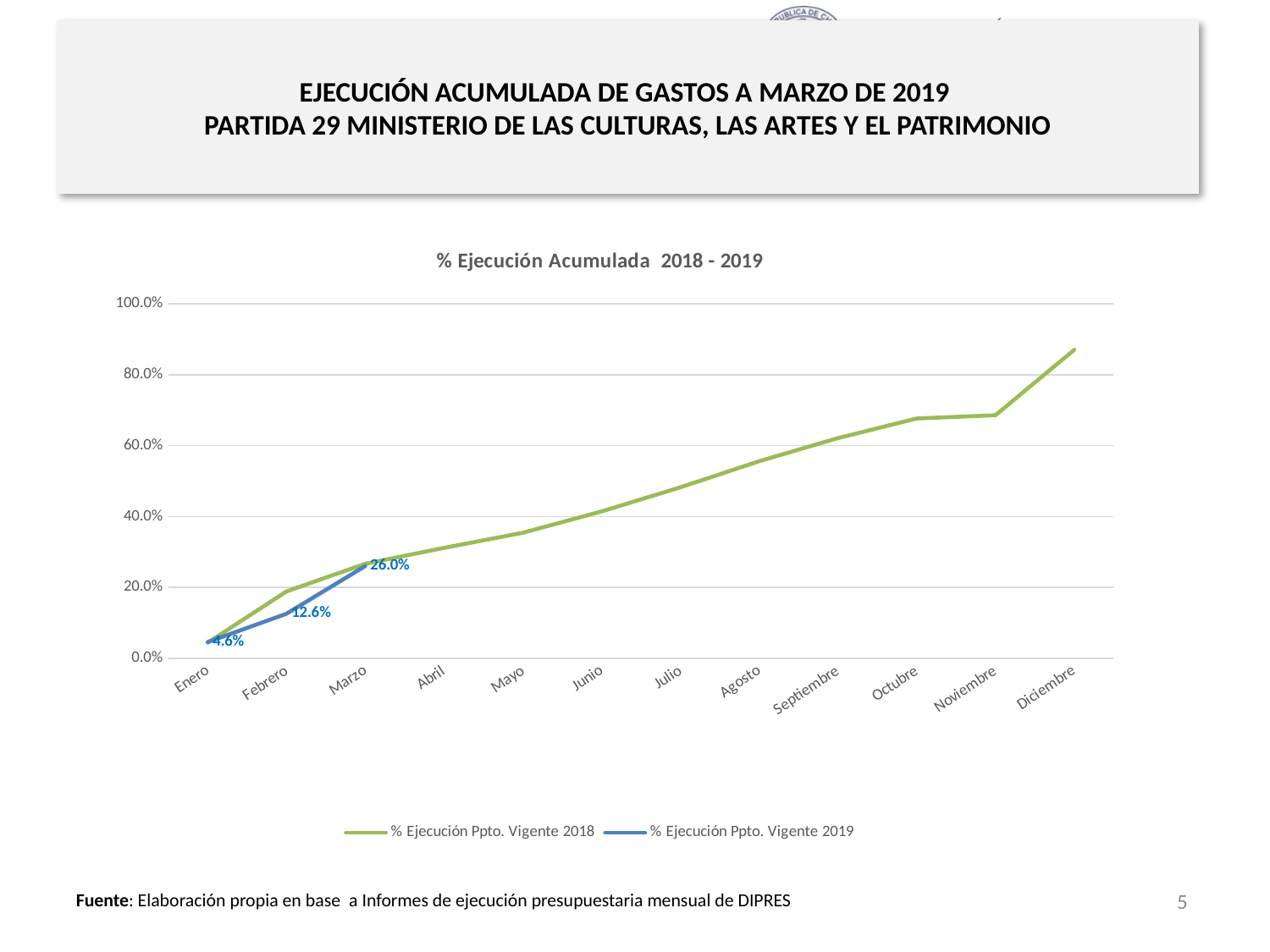
Is the value for Diciembre in the % Ejecución Ppto. Vigente 2018 series greater or less than 80.0%? greater Is the value for Mayo in the % Ejecución Ppto. Vigente 2018 series greater or less than 40.0%? less Which month has the highest value in the % Ejecución Ppto. Vigente 2019 series? Marzo What is the value for Febrero in the % Ejecución Ppto. Vigente 2019 series? 12.6% How many series does the chart legend list? 2 In Febrero, which series has the higher value: % Ejecución Ppto. Vigente 2018 or % Ejecución Ppto. Vigente 2019? % Ejecución Ppto. Vigente 2018 What kind of chart is shown on the slide? line chart What is the value for Enero in the % Ejecución Ppto. Vigente 2019 series? 4.6% What is the difference between the Marzo and Febrero values of the % Ejecución Ppto. Vigente 2019 series? 13.4% How many months are shown on the x axis of the chart? 12 Is the value for Octubre in the % Ejecución Ppto. Vigente 2018 series greater or less than 60.0%? greater What is the value for Marzo in the % Ejecución Ppto. Vigente 2019 series? 26.0%